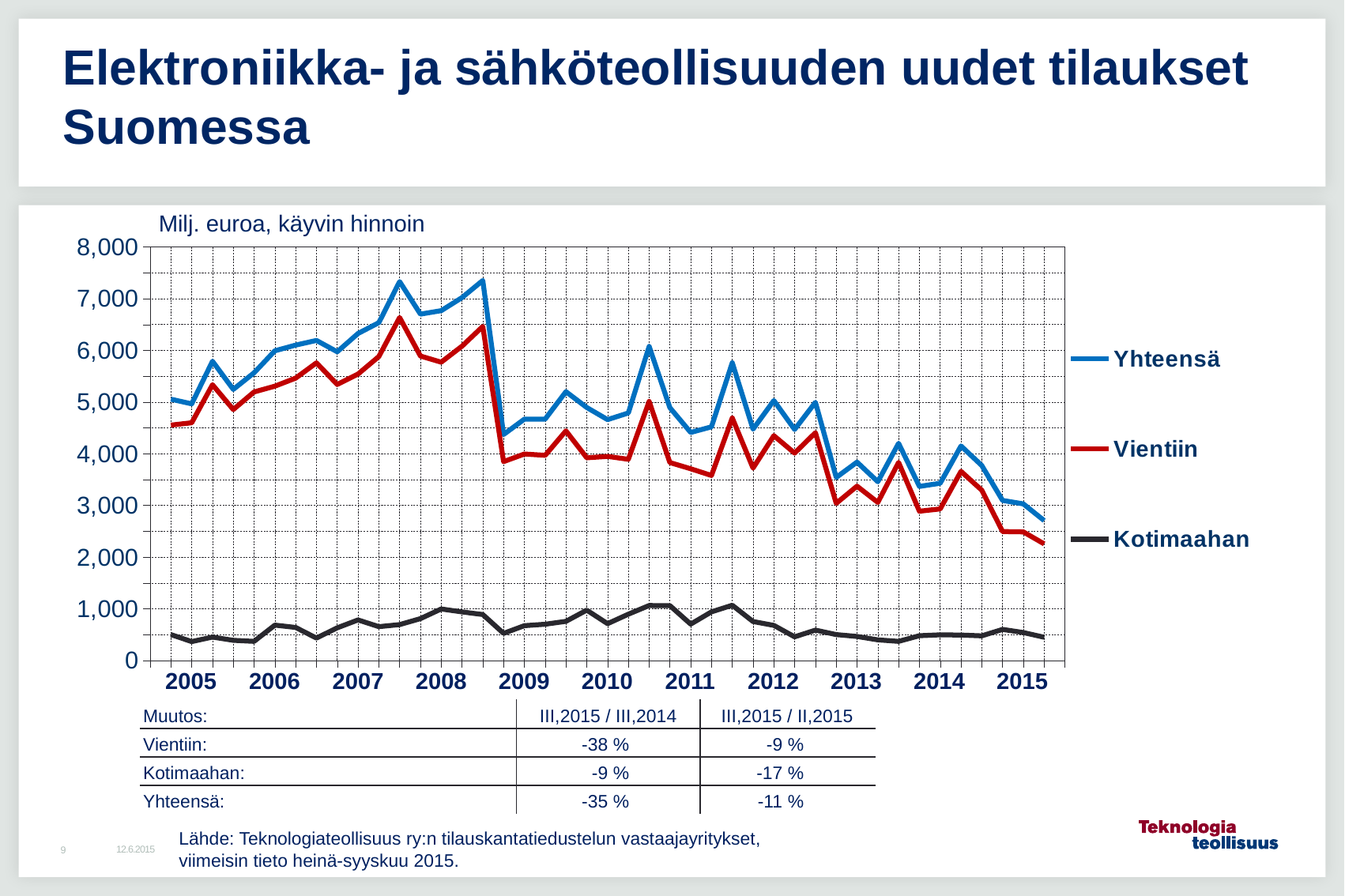
How many years are labelled on the x axis of the chart? 11 Does the Yhteensä series rise or fall overall from 2010 to 2015? fall Is the value for Vientiin at the end of 2015 greater or less than 3,000? less Is the peak value for Yhteensä in 2008 greater or less than 7,000? greater How many series does the chart legend list? 3 What unit label is shown above the chart's y axis? Milj. euroa, käyvin hinnoin What are the three series named in the chart legend? Yhteensä, Vientiin, Kotimaahan Which series has the highest values throughout the chart? Yhteensä Which series has the lowest values throughout the chart? Kotimaahan Is the value for Kotimaahan at the end of 2015 greater or less than 1,000? less What kind of chart is shown on the slide? line chart Which series is larger in 2012, Vientiin or Kotimaahan? Vientiin